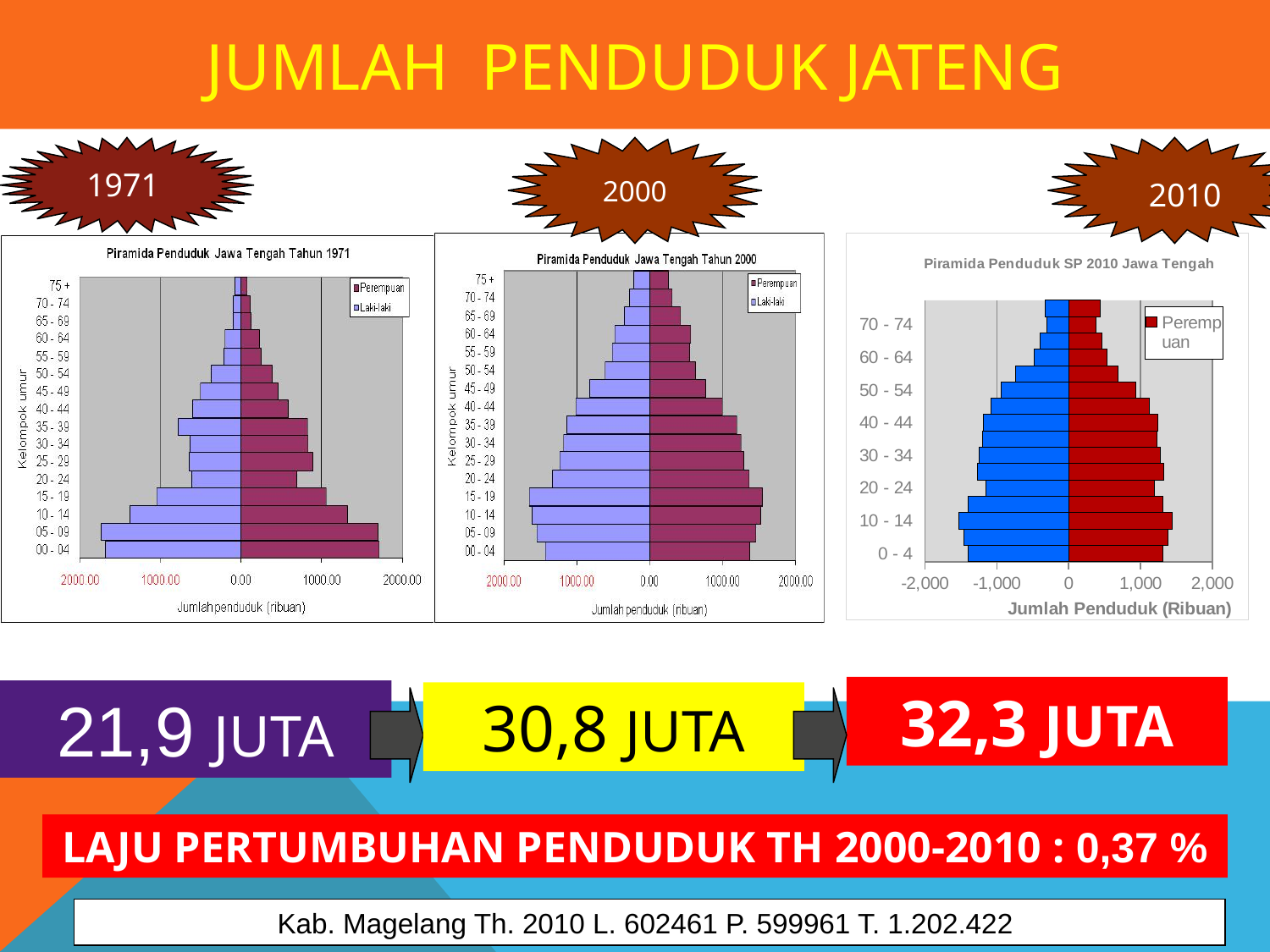
In the 'Piramida Penduduk Jawa Tengah Tahun 1971' chart, which is larger for Laki-laki: the 00 - 04 age group or the 45 - 49 age group? 00 - 04 What kind of chart is the 'Piramida Penduduk Jawa Tengah Tahun 1971' chart? Bar chart In the 'Piramida Penduduk Jawa Tengah Tahun 1971' chart, how many age groups are shown on the vertical axis? 16 In the 'Piramida Penduduk Jawa Tengah Tahun 1971' chart, do the bar lengths generally increase or decrease as the age group gets older? decrease In the 'Piramida Penduduk Jawa Tengah Tahun 2000' chart, is the Perempuan value for the 15 - 19 age group greater or less than 1000? greater In the 'Piramida Penduduk Jawa Tengah Tahun 1971' chart, is the Laki-laki value for the 05 - 09 age group greater or less than 1000? greater In the 'Piramida Penduduk Jawa Tengah Tahun 2000' chart, is the Laki-laki value for the 65 - 69 age group greater or less than 1000? less In the 'Piramida Penduduk Jawa Tengah Tahun 1971' chart, which age group has the shortest bars? 75 + In the 'Piramida Penduduk Jawa Tengah Tahun 1971' chart, how many series does the legend list? 2 What is the x-axis title of the 'Piramida Penduduk SP 2010 Jawa Tengah' chart? Jumlah Penduduk (Ribuan) In the 'Piramida Penduduk Jawa Tengah Tahun 2000' chart, which age group has the shortest bars? 75 +